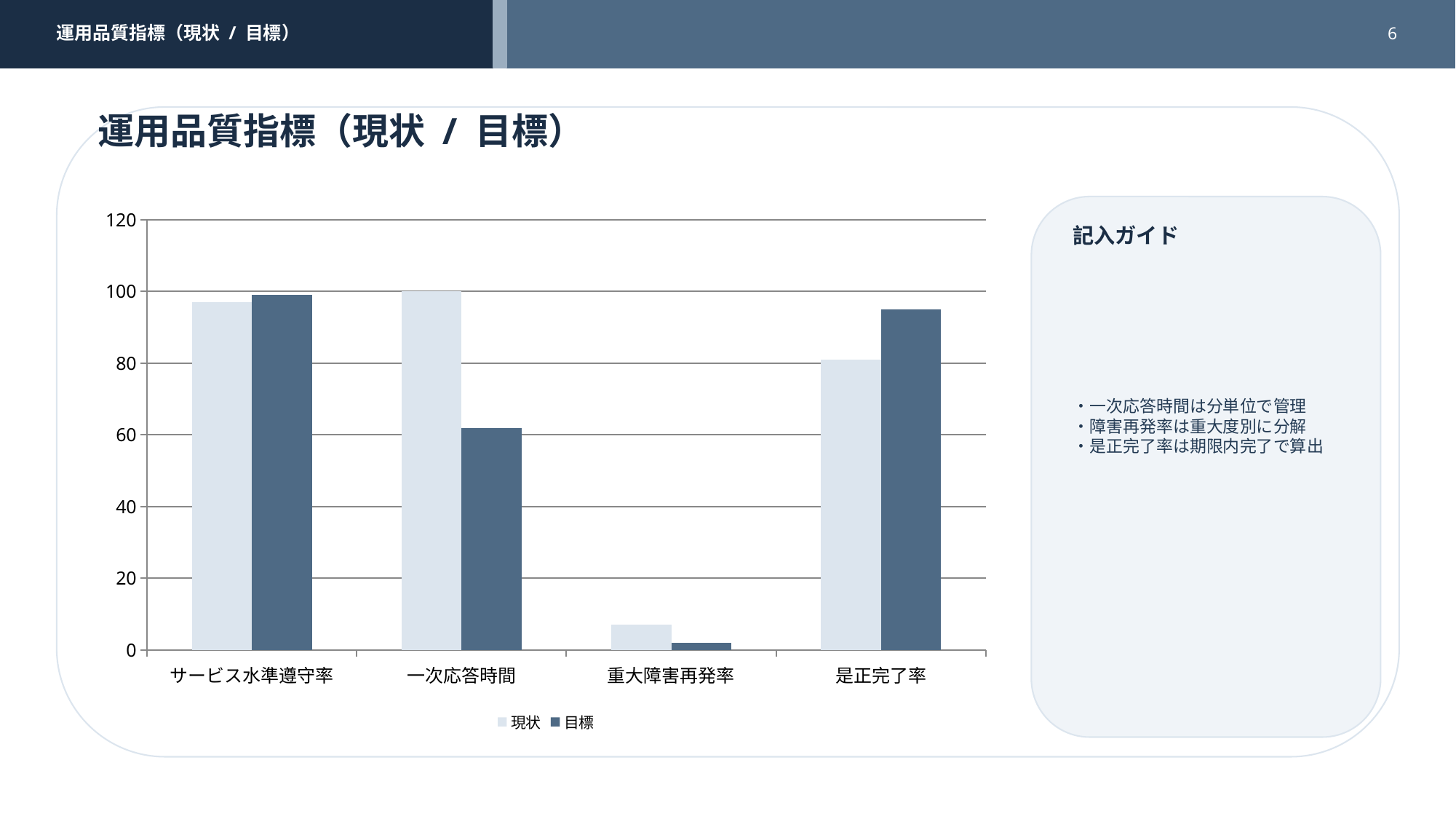
How many series does the chart legend list? 2 Which category has the highest 現状 value? 一次応答時間 How many categories are shown on the x axis of the chart? 4 Which category has the lowest 目標 value? 重大障害再発率 For 一次応答時間, which is larger: the 現状 value or the 目標 value? 現状 Is the 現状 value for 是正完了率 greater or less than 60? greater Is the 目標 value for 一次応答時間 greater or less than 80? less What kind of chart is shown on the slide? bar chart For 是正完了率, which is larger: the 現状 value or the 目標 value? 目標 What is the 現状 value for 一次応答時間? 100 What are the two series named in the chart legend? 現状, 目標 Is the 現状 value for 重大障害再発率 greater or less than 20? less